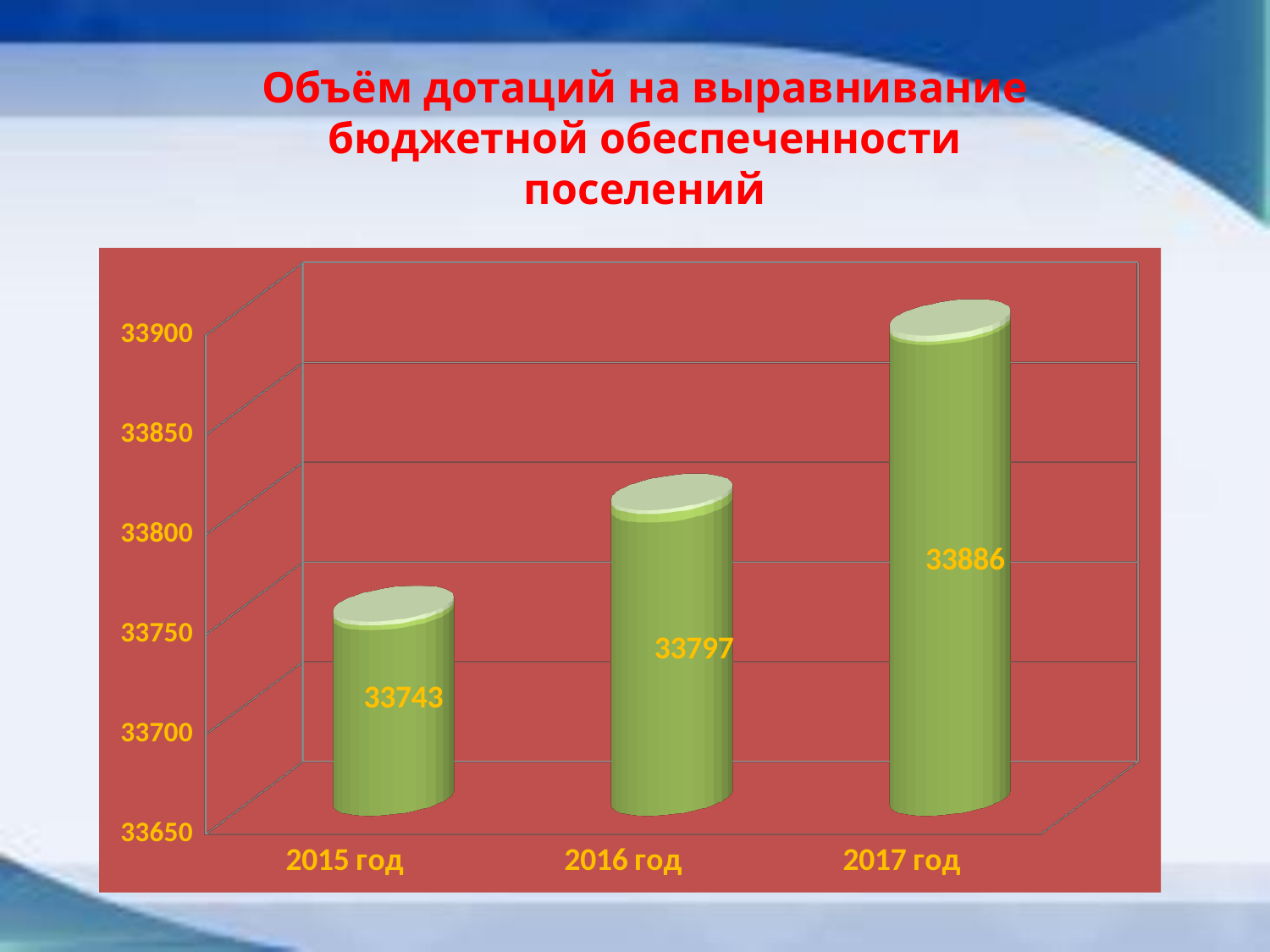
How many years are shown on the chart? 3 Do the values rise or fall from 2015 год to 2017 год? rise Which year has the highest value? 2017 год What is the value for 2015 год? 33743 Which year has the lowest value? 2015 год What is the value for 2016 год? 33797 What kind of chart is shown on the slide? bar chart Which is larger, the value for 2015 год or 2016 год? 2016 год What is the difference between the values for 2016 год and 2015 год? 54 What is the value for 2017 год? 33886 Is the value for 2017 год greater or less than 33850? greater What is the difference between the values for 2017 год and 2016 год? 89